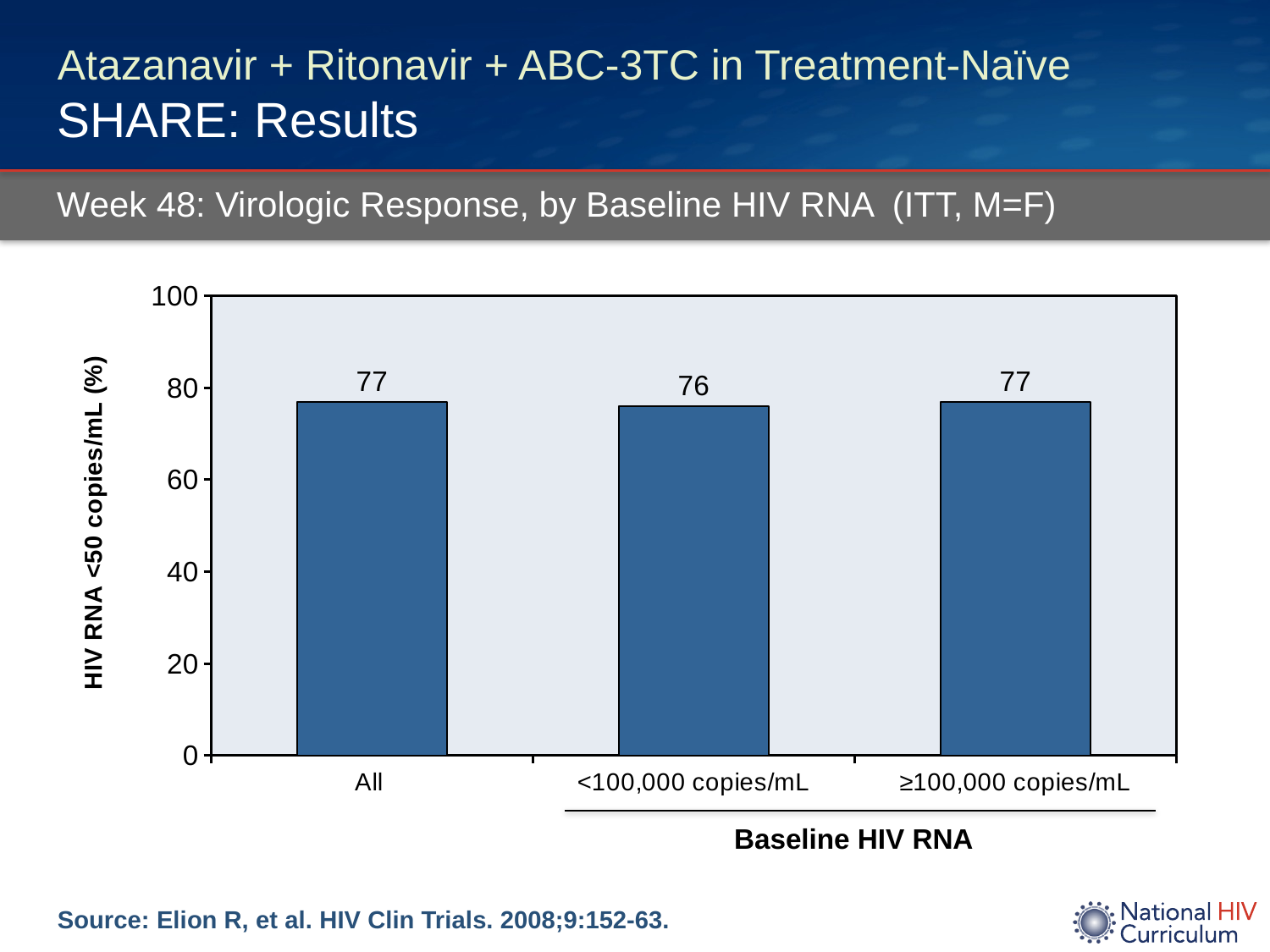
Which category has the lowest value? <100,000 copies/mL What is the label of the y axis? HIV RNA <50 copies/mL (%) Which is larger, the value for All or the value for <100,000 copies/mL? All What is the value for the ≥100,000 copies/mL baseline HIV RNA group? 77 Is the value for ≥100,000 copies/mL greater or less than 60? greater What is the value for the All group? 77 Is the value for <100,000 copies/mL greater or less than 80? less What is the value for the <100,000 copies/mL baseline HIV RNA group? 76 What kind of chart is shown on the slide? bar chart What is the difference between the values for All and <100,000 copies/mL? 1 How many categories are shown on the x axis? 3 What label groups the two rightmost categories on the x axis? Baseline HIV RNA